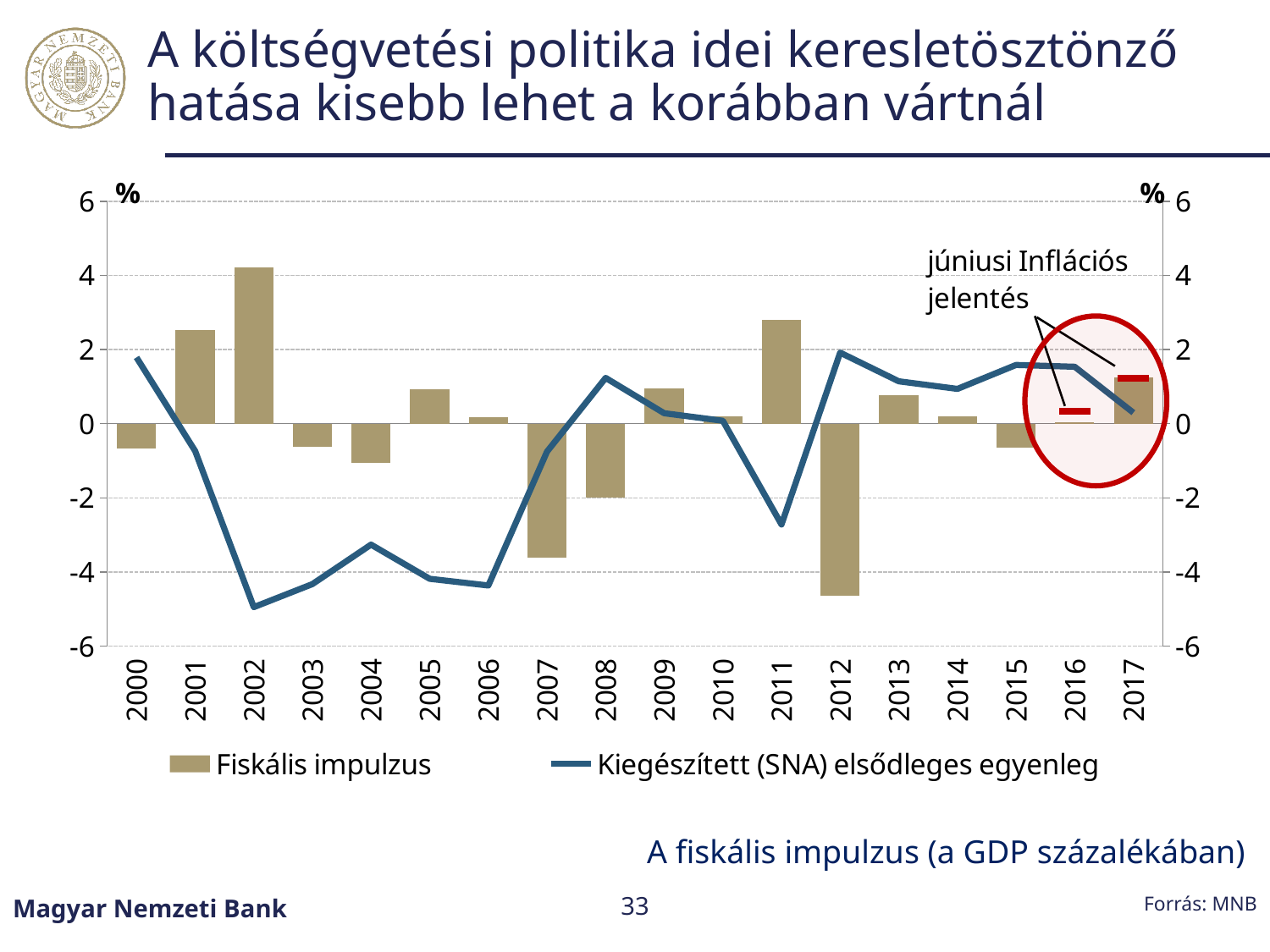
In which year is the Fiskális impulzus bar the highest? 2002 Is the Kiegészített (SNA) elsődleges egyenleg value for 2011 greater or less than -2? less What text labels the annotation pointing to the red dashes in the circled area? júniusi Inflációs jelentés Which year has the larger Fiskális impulzus bar, 2011 or 2001? 2011 In which year is the Fiskális impulzus bar the lowest? 2012 In which year does the Kiegészített (SNA) elsődleges egyenleg line reach its lowest point? 2002 How many series does the legend list? 2 Is the Fiskális impulzus value for 2002 greater or less than 4? greater How many years are shown on the x axis? 18 Does the Kiegészített (SNA) elsődleges egyenleg line rise or fall from 2000 to 2002? Fall What kind of chart is shown on the slide? A combined bar and line chart Is the Fiskális impulzus value for 2012 greater or less than -4? less